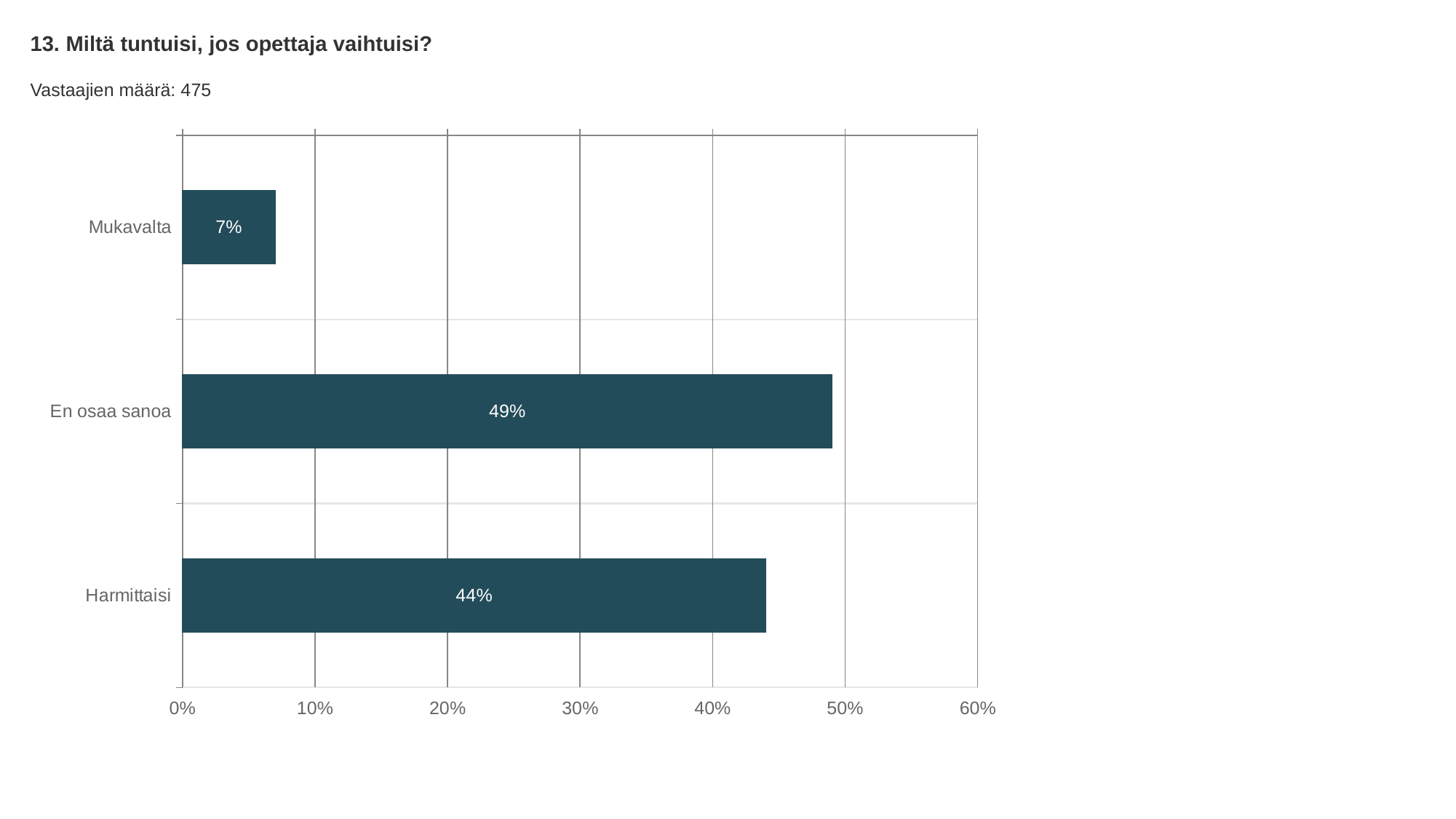
Which category has the highest value? En osaa sanoa What is the value for Harmittaisi? 44% What is the value for En osaa sanoa? 49% What kind of chart is shown on the slide? bar chart How many categories are shown in the chart? 3 How many respondents (Vastaajien määrä) are reported on the slide? 475 Is the value for Harmittaisi greater or less than 40%? greater What is the value for Mukavalta? 7% What is the difference between the values for En osaa sanoa and Harmittaisi? 5% Which category has the lowest value? Mukavalta What is the difference between the values for Harmittaisi and Mukavalta? 37% Which is larger, the value for Harmittaisi or the value for Mukavalta? Harmittaisi